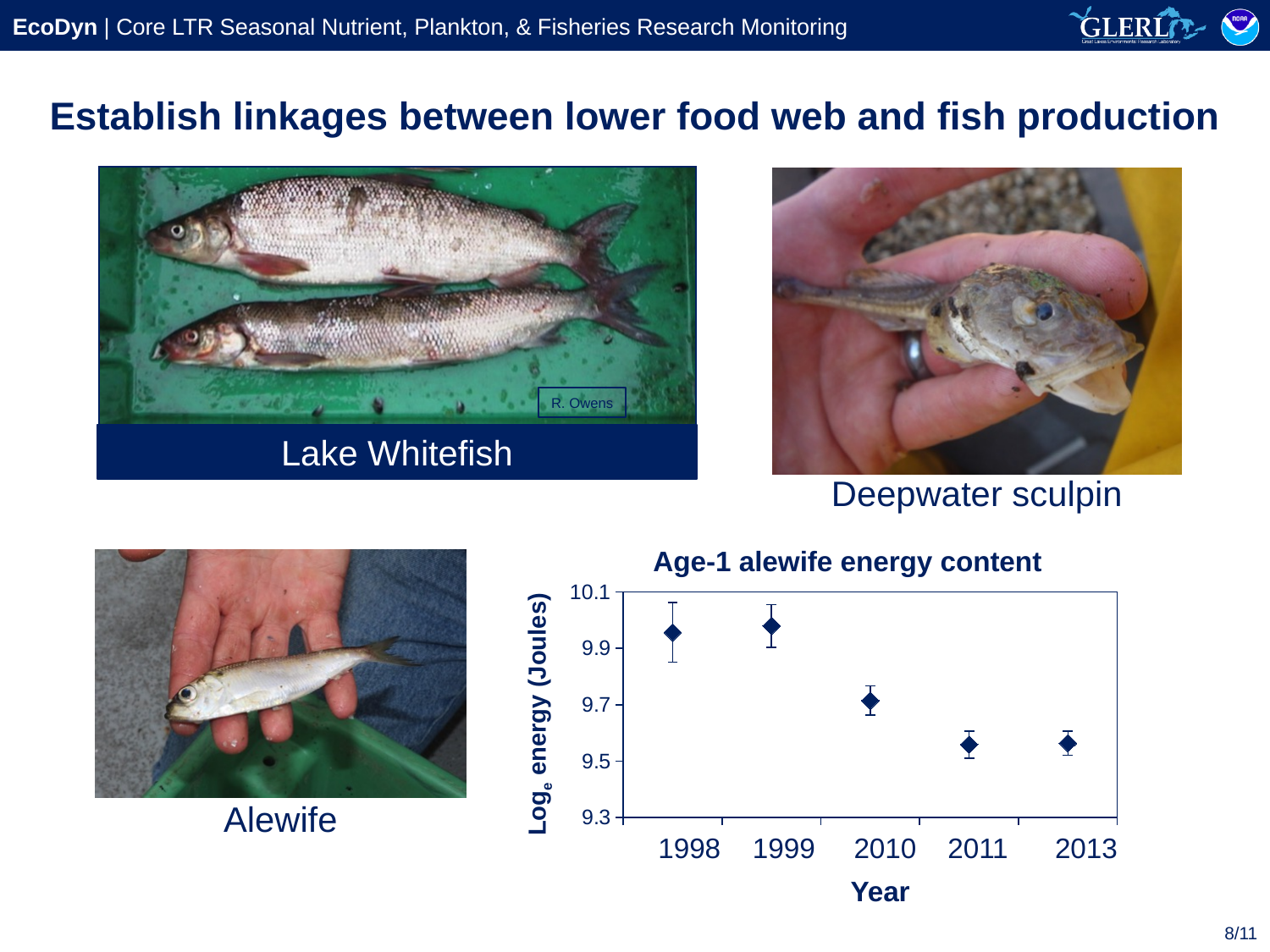
What kind of chart is shown on the slide? Scatter chart What is the title of the chart on the slide? Age-1 alewife energy content What is the label of the x axis in the Age-1 alewife energy content chart? Year In the Age-1 alewife energy content chart, which year has the higher value, 2010 or 2013? 2010 How many years are plotted in the Age-1 alewife energy content chart? 5 In the Age-1 alewife energy content chart, is the value for 2013 greater or less than 9.7? less In the Age-1 alewife energy content chart, which year has the higher value, 1999 or 2011? 1999 In the Age-1 alewife energy content chart, is the value for 1998 greater or less than 9.7? greater In the Age-1 alewife energy content chart, do the values generally rise or fall from 1998 to 2013? Fall In the Age-1 alewife energy content chart, is the value for 2011 greater or less than 9.7? less